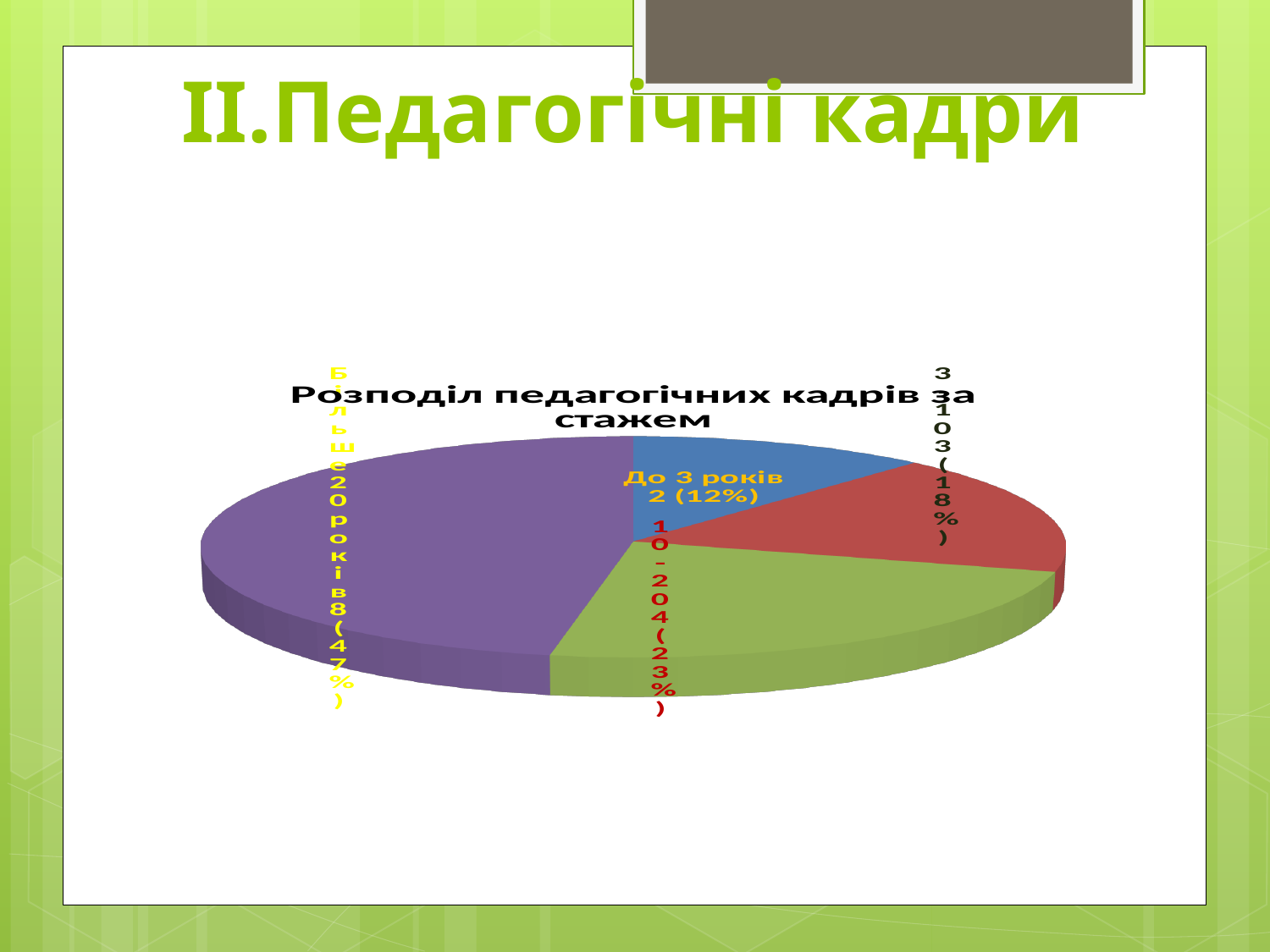
What is the difference in number of teachers between 'Більше 20 років' and '10-20'? 4 Which category has the smallest slice? До 3 років What is the title of the chart? Розподіл педагогічних кадрів за стажем How many teachers are in the 'До 3 років' category? 2 What colour is the 'Більше 20 років' slice? Purple How many teachers are in the '3-10' category? 3 What percentage share does the 'Більше 20 років' slice have? 47% Which category has more teachers, '3-10' or '10-20'? 10-20 Which category has the largest slice? Більше 20 років What percentage share does the '10-20' slice have? 23% How many slices does the pie chart have? 4 What type of chart is shown on the slide? Pie chart